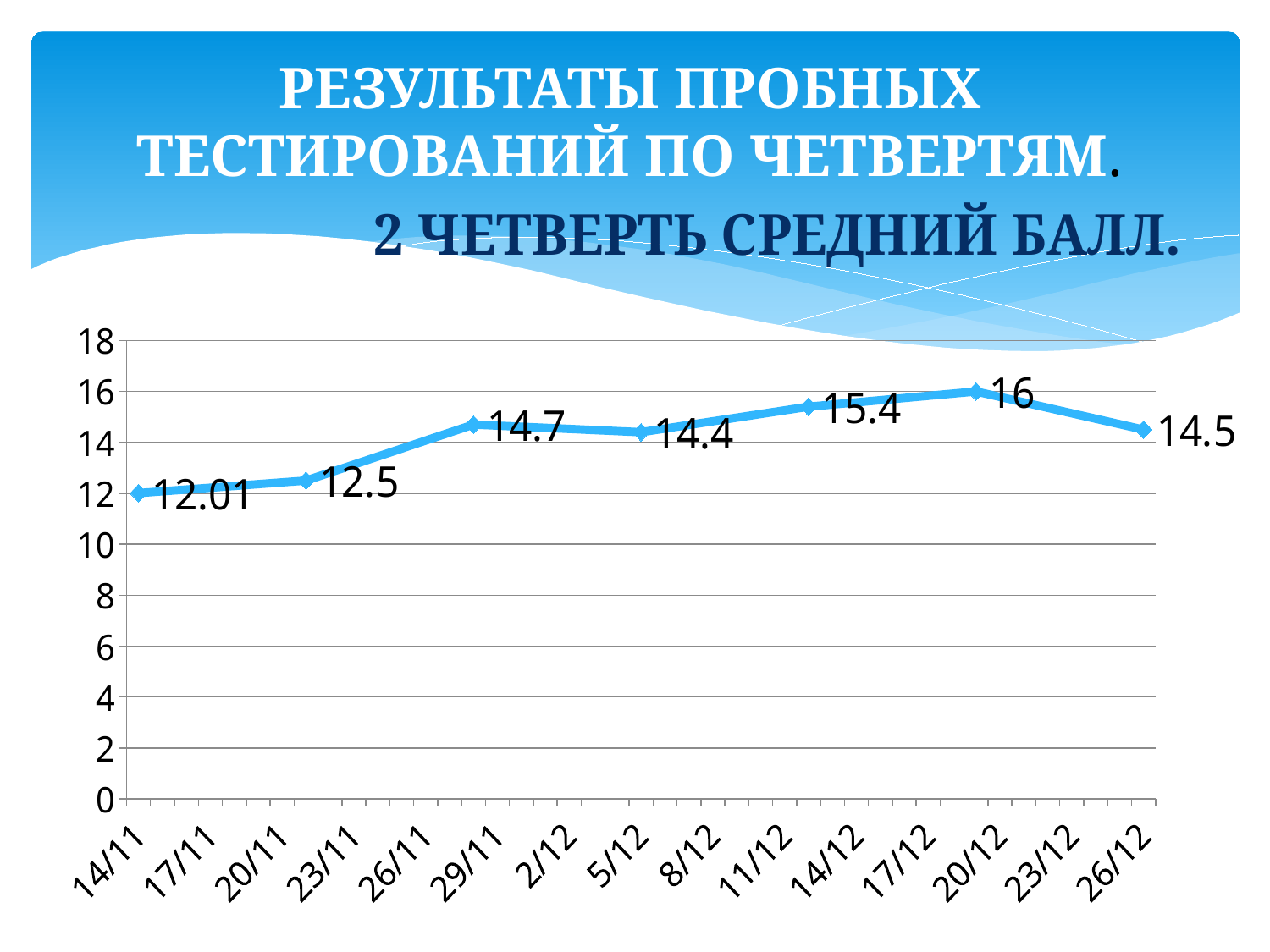
What is the highest value plotted on the chart? 16 What is the value of the data point at 5/12? 14.4 Which is larger: the value at 14/11 or the value at 26/12? 26/12 What is the value of the last data point, at 26/12? 14.5 Is the value at 26/12 greater or less than 14? greater What is the value of the first data point, at 14/11? 12.01 What is the lowest value plotted on the chart? 12.01 What is the maximum value shown on the vertical axis? 18 What is the difference between the highest value (16) and the value at 26/12 (14.5)? 1.5 What type of chart is shown on the slide? line chart What is the difference between the value at 5/12 (14.4) and the value at 14/11 (12.01)? 2.39 How many data points are plotted on the line? 7